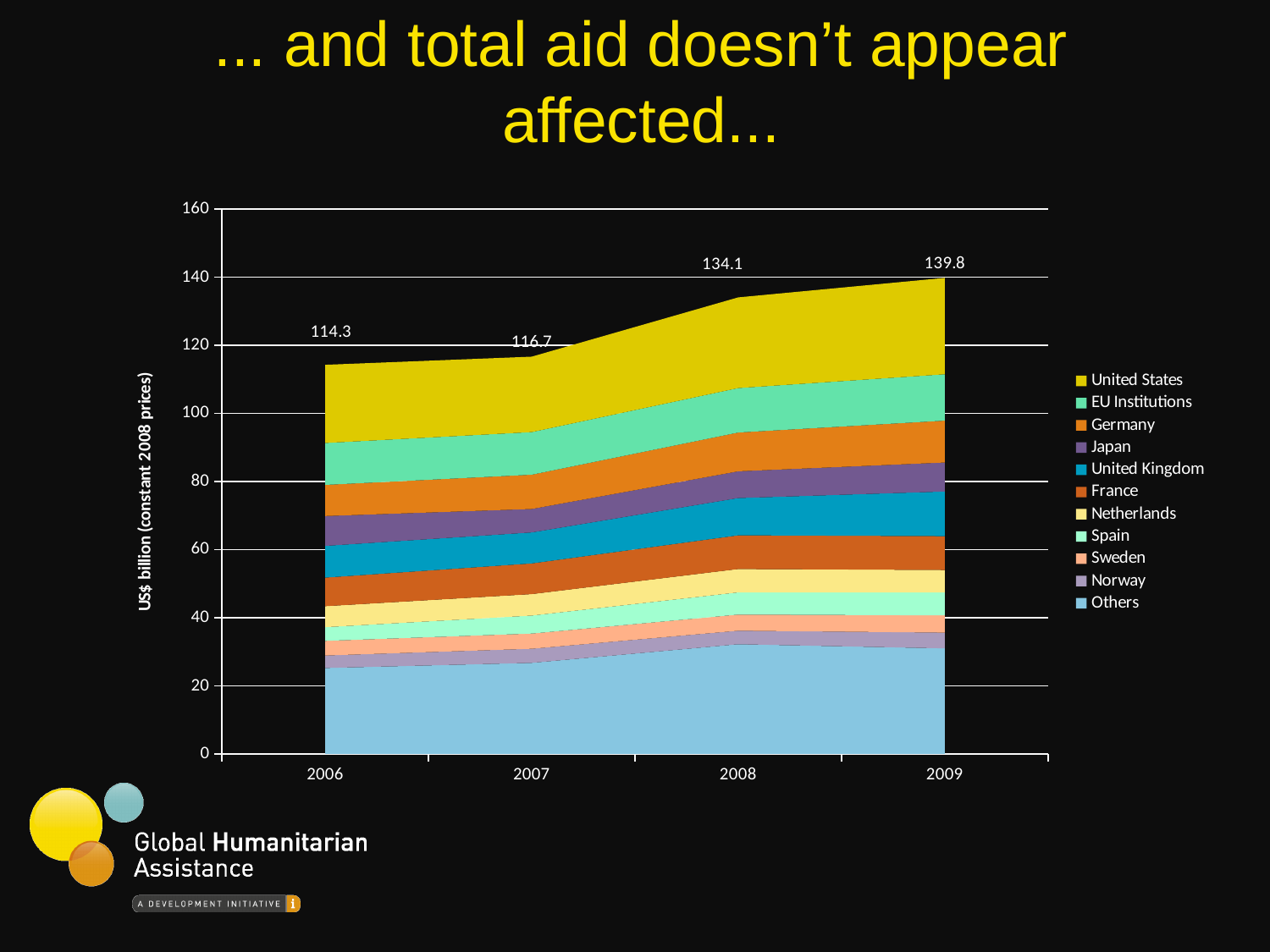
Which year has a larger total aid, 2007 or 2008? 2008 How many years are shown on the x axis? 4 Is the total aid for 2007 greater or less than 120? less How many series does the legend list? 11 What is the total aid value shown for 2008? 134.1 What is the total aid value shown for 2006? 114.3 Which year has the lowest total aid? 2006 Which year has the highest total aid? 2009 Does total aid rise or fall from 2006 to 2009? Rise What is the difference between the total aid in 2009 and in 2006? 25.5 What kind of chart is shown on the slide? Stacked area chart What is the total aid value shown for 2009? 139.8